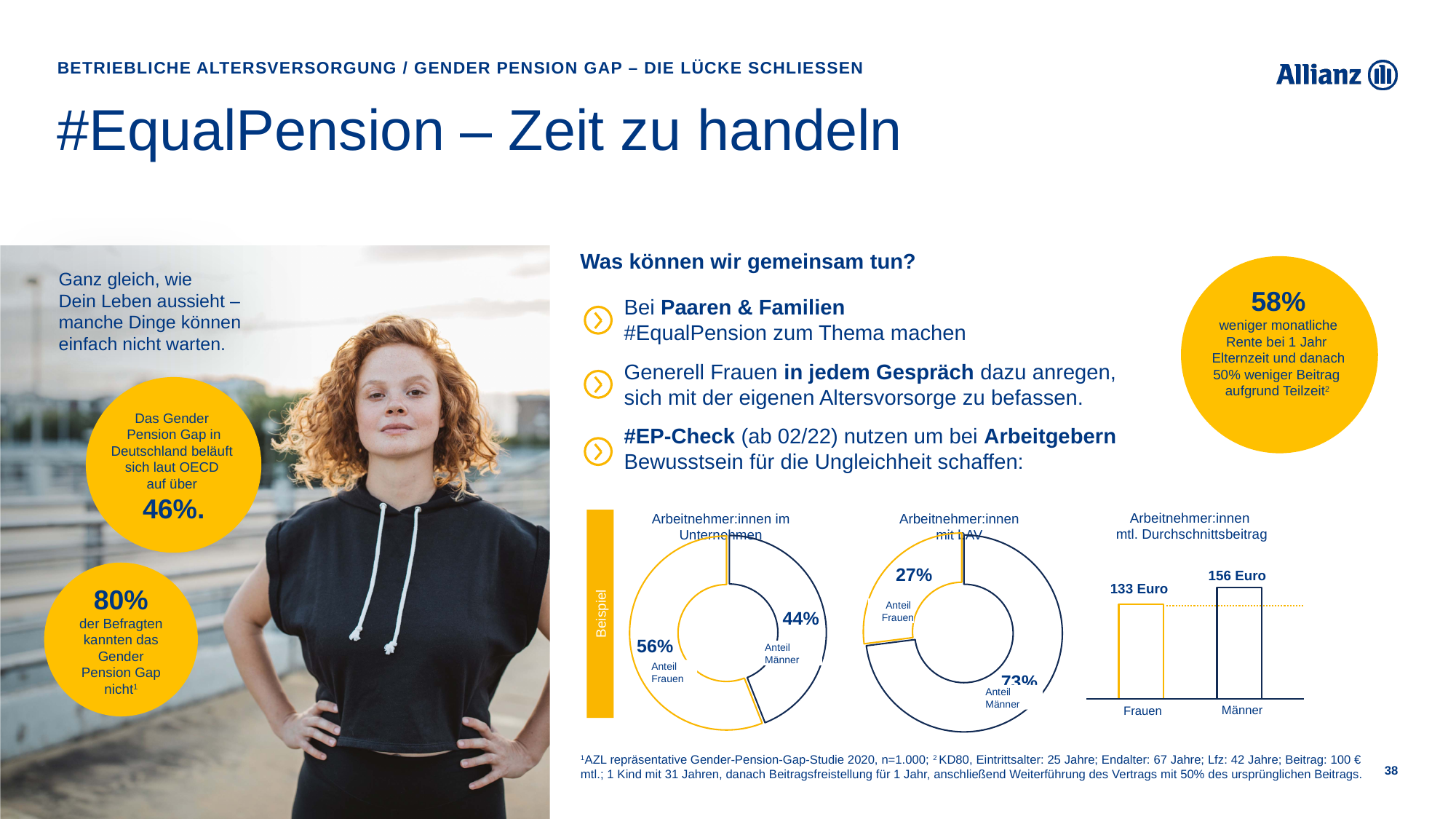
In the chart 'Arbeitnehmer:innen im Unternehmen', what is the difference between the shares for Anteil Frauen and Anteil Männer? 12% In the chart 'Arbeitnehmer:innen mtl. Durchschnittsbeitrag', what is the value for Männer? 156 Euro In the chart 'Arbeitnehmer:innen im Unternehmen', what is the share for Anteil Frauen? 56% In the chart 'Arbeitnehmer:innen mit bAV', what is the share for Anteil Frauen? 27% In the chart 'Arbeitnehmer:innen mit bAV', which group has the larger share? Anteil Männer In the chart 'Arbeitnehmer:innen mtl. Durchschnittsbeitrag', what is the value for Frauen? 133 Euro How many categories are shown in the chart 'Arbeitnehmer:innen mtl. Durchschnittsbeitrag'? 2 What kind of chart is 'Arbeitnehmer:innen mtl. Durchschnittsbeitrag'? Bar chart In the chart 'Arbeitnehmer:innen mtl. Durchschnittsbeitrag', which category has the higher value? Männer In the chart 'Arbeitnehmer:innen mit bAV', what is the share for Anteil Männer? 73% In the chart 'Arbeitnehmer:innen mtl. Durchschnittsbeitrag', what is the difference between the values for Männer and Frauen? 23 Euro In the chart 'Arbeitnehmer:innen im Unternehmen', what is the share for Anteil Männer? 44%